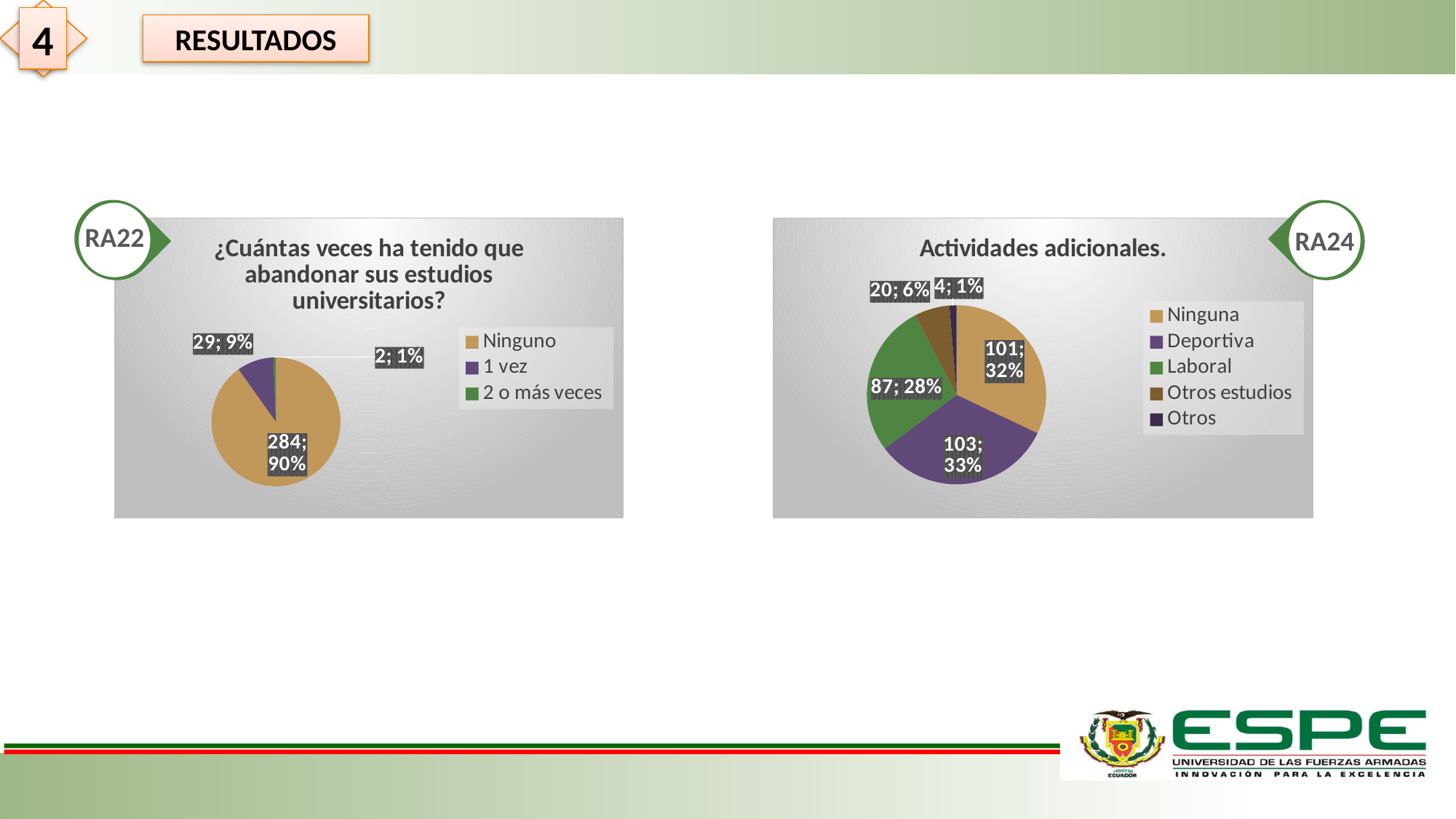
In the right chart (Actividades adicionales.), what share of the pie does Deportiva represent? 33% In the left chart (¿Cuántas veces ha tenido que abandonar sus estudios universitarios?), what is the count for Ninguno? 284 In the left chart (¿Cuántas veces ha tenido que abandonar sus estudios universitarios?), what share of the pie does 1 vez represent? 9% In the left chart (¿Cuántas veces ha tenido que abandonar sus estudios universitarios?), how many categories does the legend list? 3 In the left chart (¿Cuántas veces ha tenido que abandonar sus estudios universitarios?), what is the difference between the counts for Ninguno and 1 vez? 255 In the right chart (Actividades adicionales.), what is the count for Laboral? 87 In the right chart (Actividades adicionales.), how many categories does the legend list? 5 In the right chart (Actividades adicionales.), which category has the largest count? Deportiva In the right chart (Actividades adicionales.), which category has the smallest count? Otros In the left chart (¿Cuántas veces ha tenido que abandonar sus estudios universitarios?), which category has the smallest slice? 2 o más veces What kind of chart is the right chart (Actividades adicionales.)? Pie chart In the right chart (Actividades adicionales.), what is the difference between the counts for Laboral and Otros estudios? 67